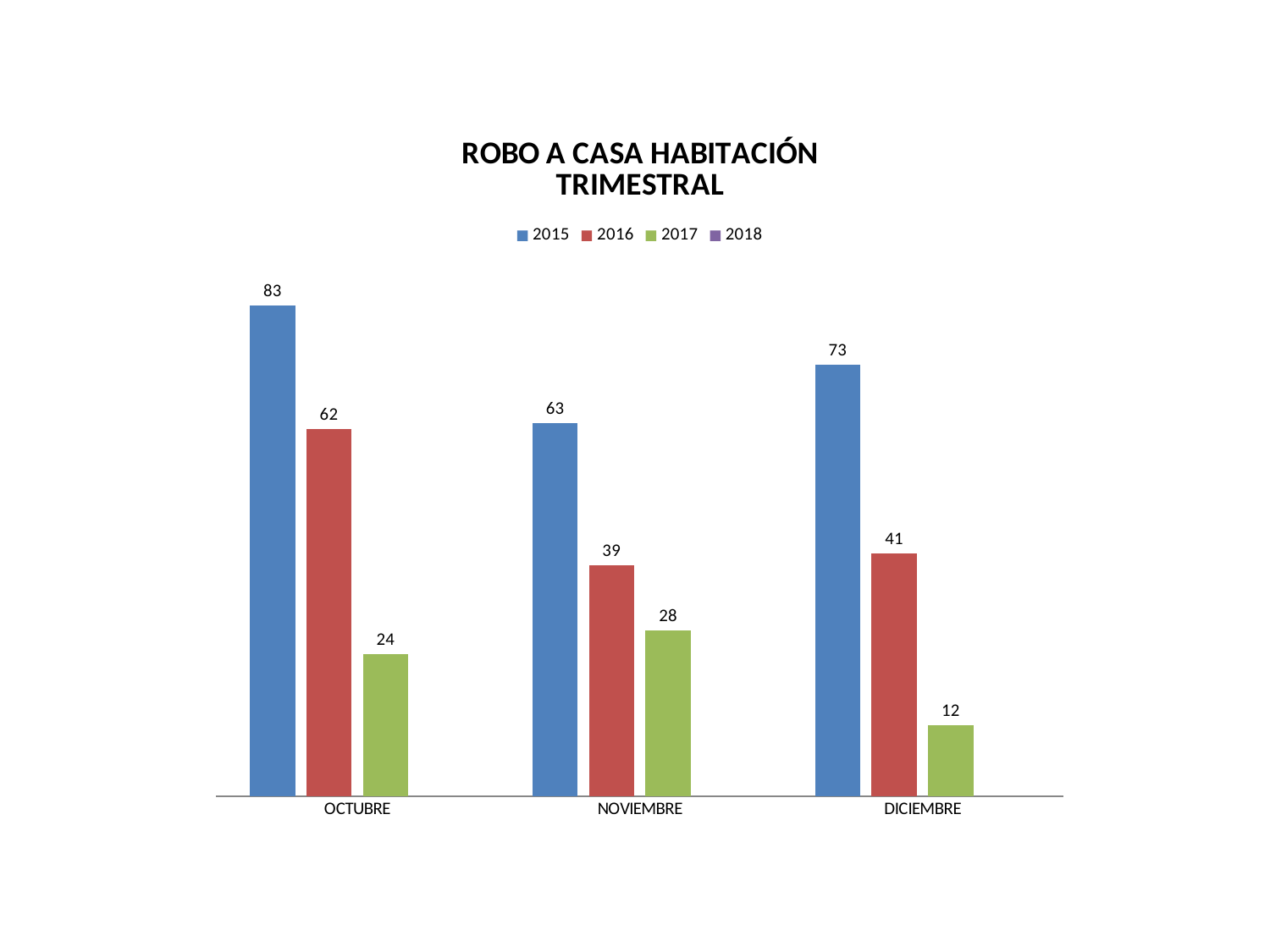
What is the title of the chart? ROBO A CASA HABITACIÓN TRIMESTRAL Which month has the highest value for the 2015 series? OCTUBRE What is the value for 2015 in OCTUBRE? 83 What kind of chart is shown? Bar chart What is the value for 2017 in DICIEMBRE? 12 What is the difference between the 2015 and 2016 values in DICIEMBRE? 32 Which month has the lowest value for the 2017 series? DICIEMBRE Which is larger, the 2016 value in OCTUBRE or the 2015 value in NOVIEMBRE? 2015 value in NOVIEMBRE Does the 2016 series rise or fall from OCTUBRE to NOVIEMBRE? Fall How many months are shown on the x axis? 3 How many series does the legend list? 4 What is the value for 2016 in NOVIEMBRE? 39